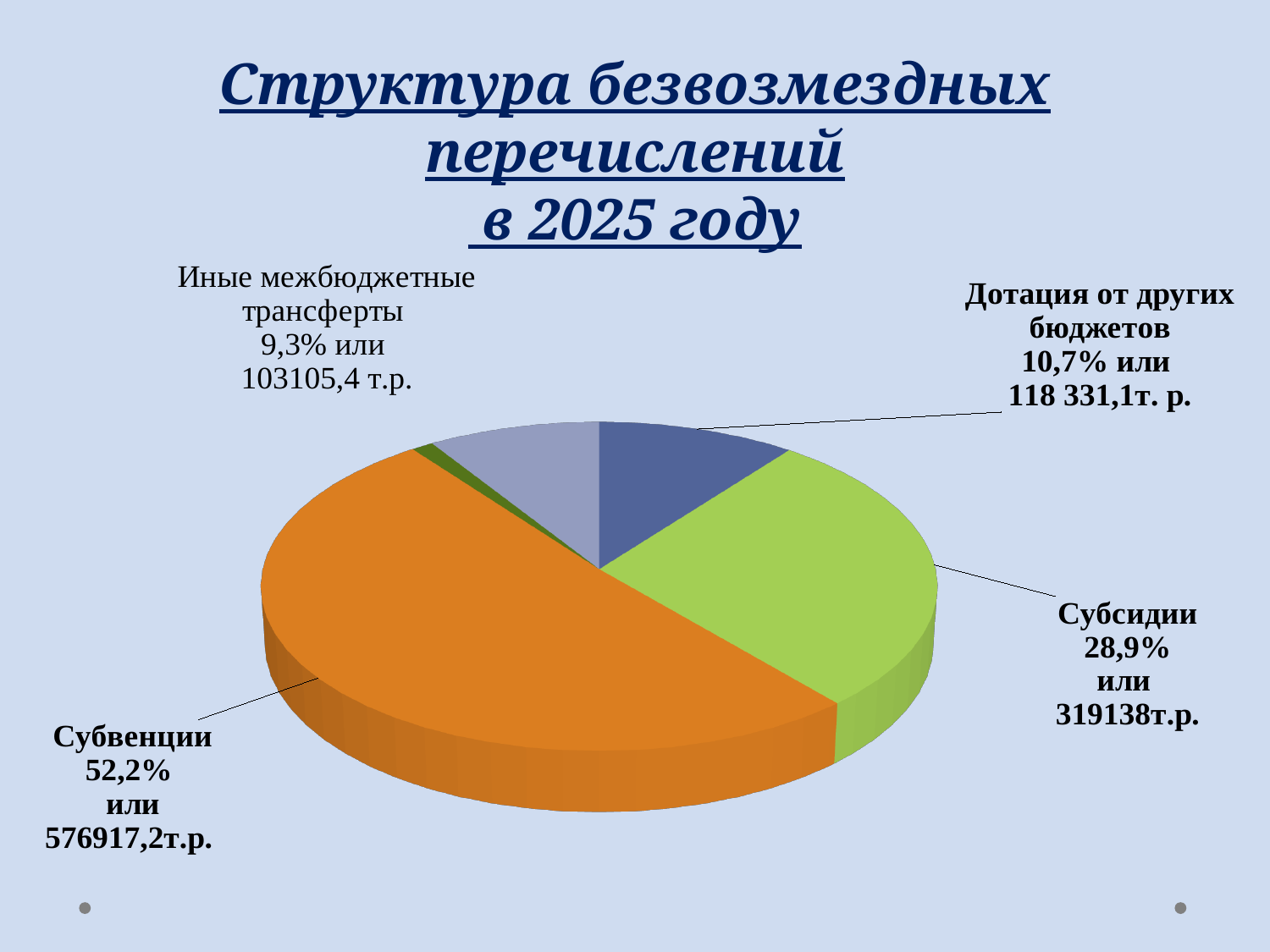
What is the difference in percentage points between the shares of Субвенции and Субсидии? 23,3 What is the value shown for Дотация от других бюджетов in т.р.? 118 331,1т. р. What share of the pie does Дотация от других бюджетов account for? 10,7% What is the value shown for Субвенции in т.р.? 576917,2т.р. What is the value shown for Иные межбюджетные трансферты in т.р.? 103105,4 т.р. What share of the pie does Субвенции account for? 52,2% What kind of chart is shown on the slide? pie chart What is the value shown for Субсидии in т.р.? 319138т.р. What share of the pie does Субсидии account for? 28,9% Which is larger, the share for Дотация от других бюджетов or the share for Иные межбюджетные трансферты? Дотация от других бюджетов Which labeled category has the largest share of the pie? Субвенции